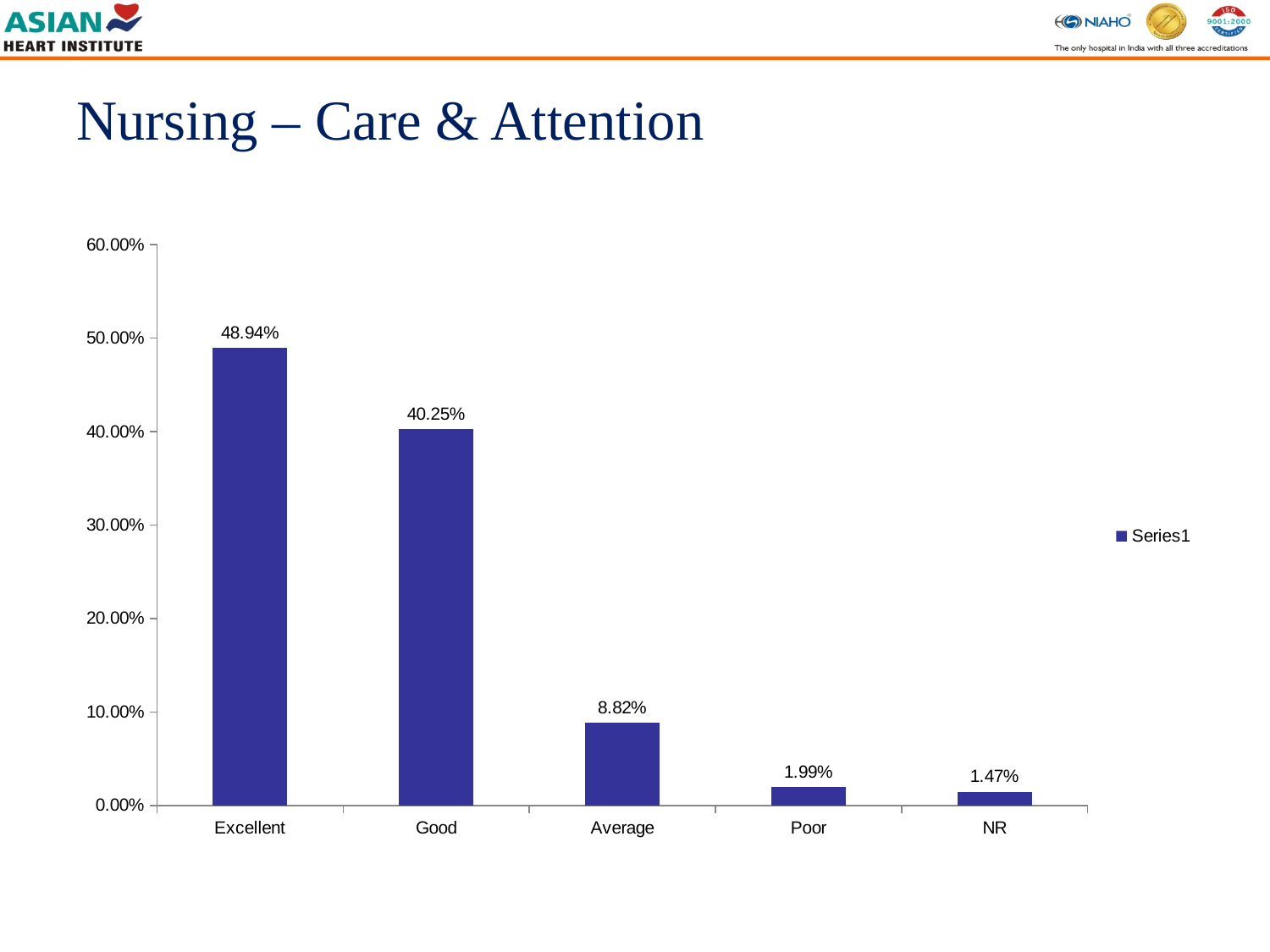
What is the value for NR? 1.47% Which is larger, the value for Average or the value for Poor? Average What is the value for Good? 40.25% How many categories are shown on the x axis? 5 Which category has the highest value? Excellent What is the value for Excellent? 48.94% What is the title of the slide containing the chart? Nursing – Care & Attention What kind of chart is shown on the slide? Bar chart Which category has the lowest value? NR What is the value for Average? 8.82% What is the difference between the values for Excellent and Good? 8.69% What is the value for Poor? 1.99%